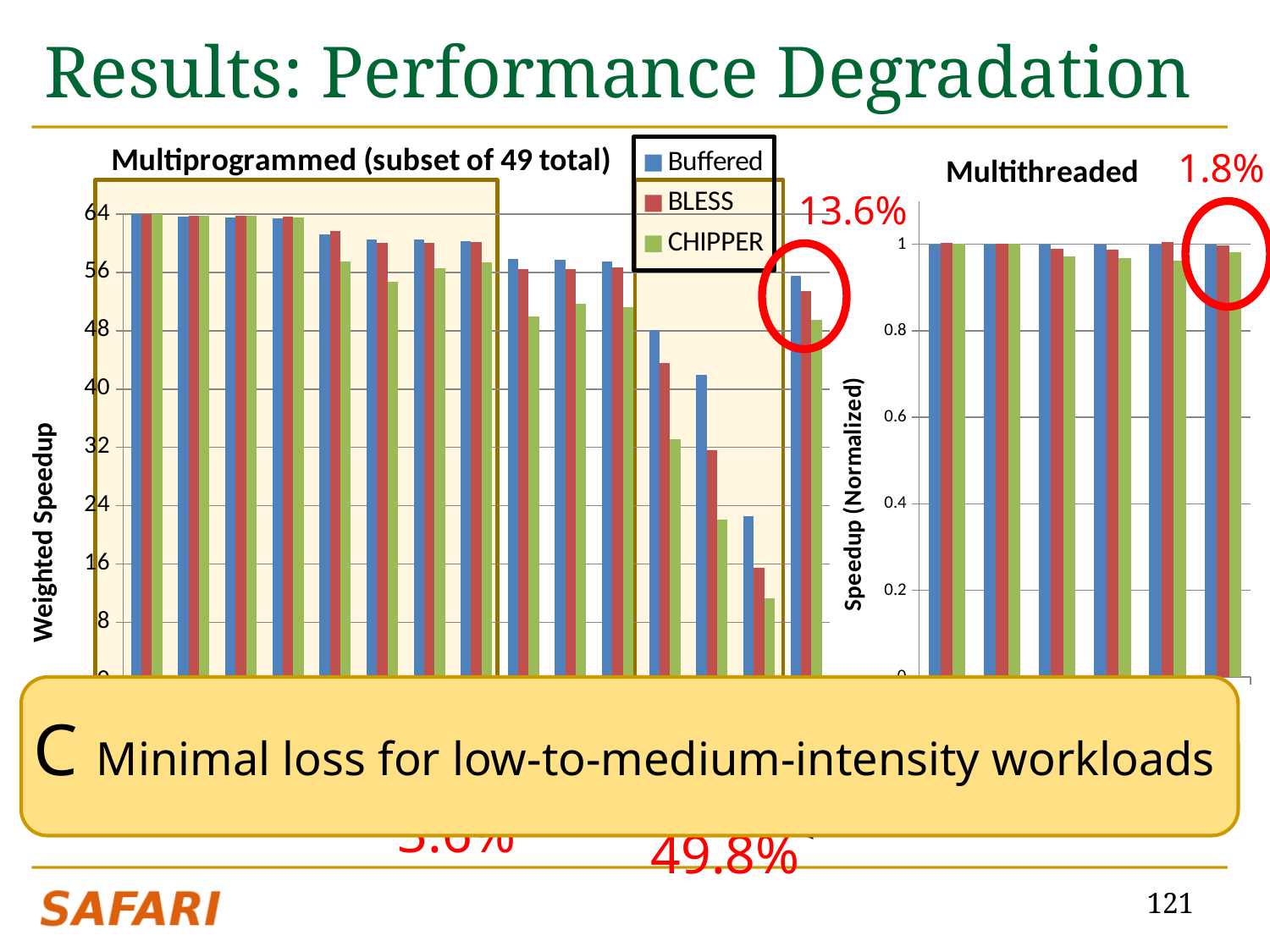
How many series does the legend list? 3 In the Multiprogrammed (subset of 49 total) chart, which series has the tallest bar in the group with the lowest values? Buffered How many groups of bars are plotted in the Multithreaded chart? 6 How many groups of bars are plotted in the Multiprogrammed (subset of 49 total) chart? 15 What kind of chart is the Multiprogrammed (subset of 49 total) chart? bar chart What is the y-axis title of the Multithreaded chart? Speedup (Normalized) What percentage is annotated next to the red circle on the Multithreaded chart? 1.8% In the Multithreaded chart, is the Buffered value for the first group of bars greater or less than 0.8? greater What is the highest tick value shown on the y-axis of the Multiprogrammed (subset of 49 total) chart? 64 Which series are listed in the legend? Buffered, BLESS, CHIPPER In the Multiprogrammed (subset of 49 total) chart, is the CHIPPER value in the group with the lowest bars greater or less than 16? less In the Multiprogrammed (subset of 49 total) chart, is the Buffered value for the first group of bars greater or less than 56? greater